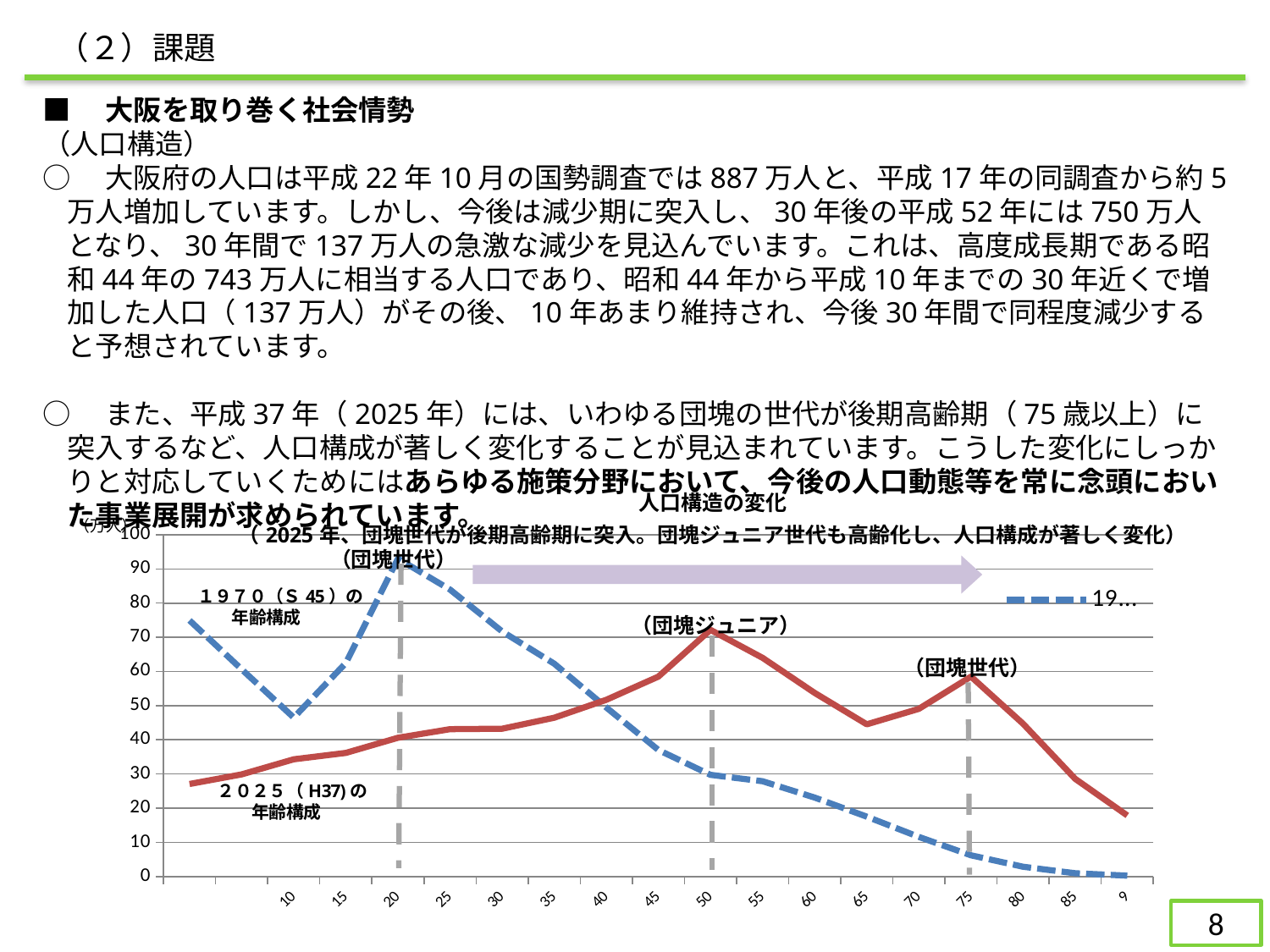
Is the value of the 1970 (S45) series at age 85 greater or less than 10? less What kind of chart is shown on the slide? line chart What is the title of the chart? 人口構造の変化 How many series are plotted in the chart? 2 Does the 1970 (S45) series rise or fall from age 20 to age 85? fall Is the value of the 1970 (S45) series at age 20 greater or less than 80? greater At which age on the x axis does the 1970 (S45) series reach its highest value? 20 Is the value of the 2025 (H37) series at age 50 greater or less than 60? greater At age 75, which series has the larger value, 1970 (S45) or 2025 (H37)? 2025 (H37) At age 20, which series has the larger value, 1970 (S45) or 2025 (H37)? 1970 (S45) At which age on the x axis does the 2025 (H37) series reach its highest value? 50 Which series is drawn as a dashed line, the 1970 (S45) age composition or the 2025 (H37) age composition? 1970 (S45) の年齢構成